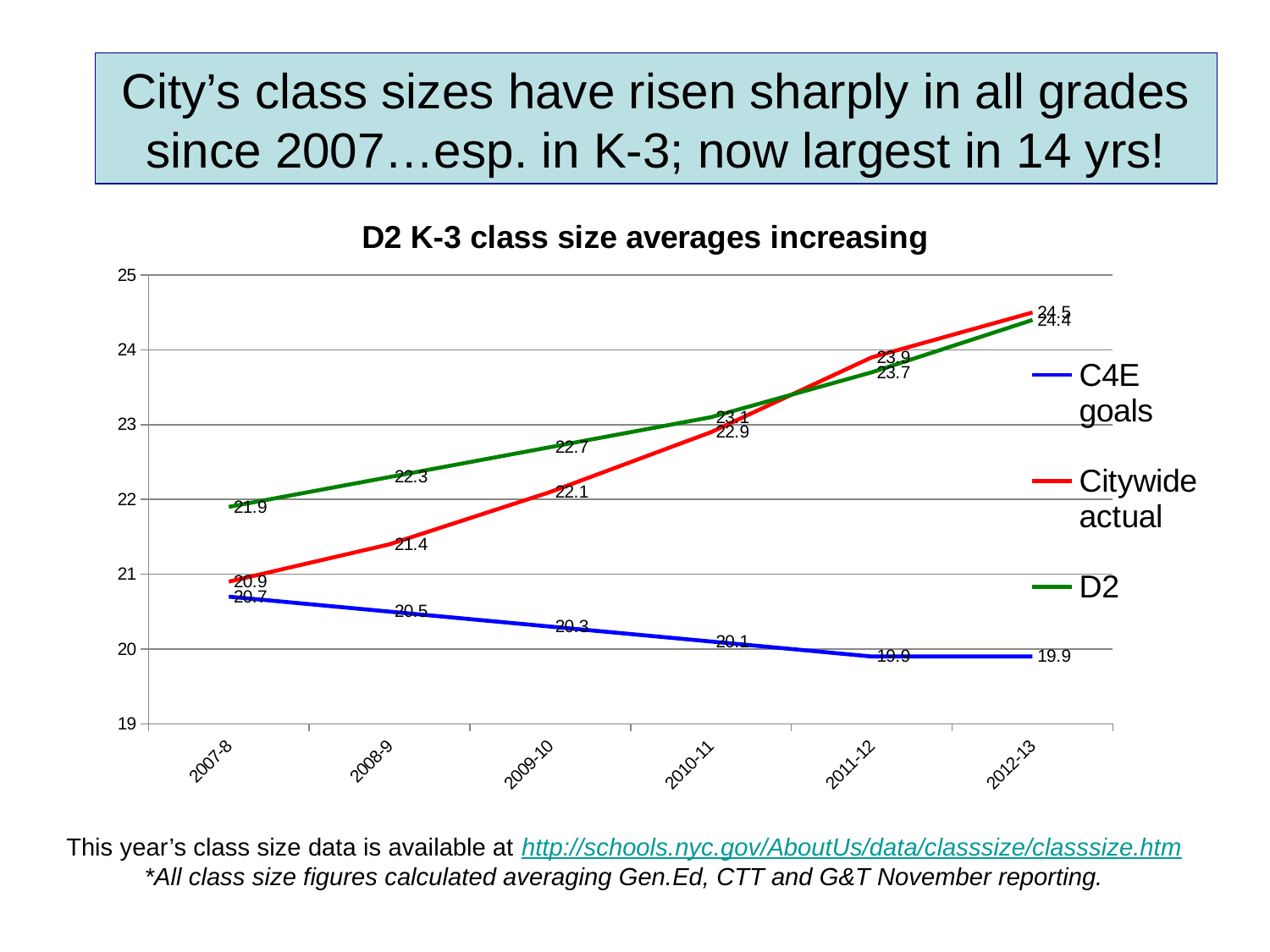
Do the C4E goals values rise or fall from 2007-8 to 2012-13? fall What is the title of the chart? D2 K-3 class size averages increasing In which year is the Citywide actual value lowest? 2007-8 What type of chart is shown on the slide? line chart In which year is the D2 value highest? 2012-13 What is the C4E goals value for 2012-13? 19.9 Which is larger in 2008-9, the D2 value or the Citywide actual value? D2 How many school years are shown on the x axis? 6 What is the difference between the D2 value and the C4E goals value in 2010-11? 3 What is the Citywide actual value for 2009-10? 22.1 How many series does the legend list? 3 What is the D2 value for 2008-9? 22.3